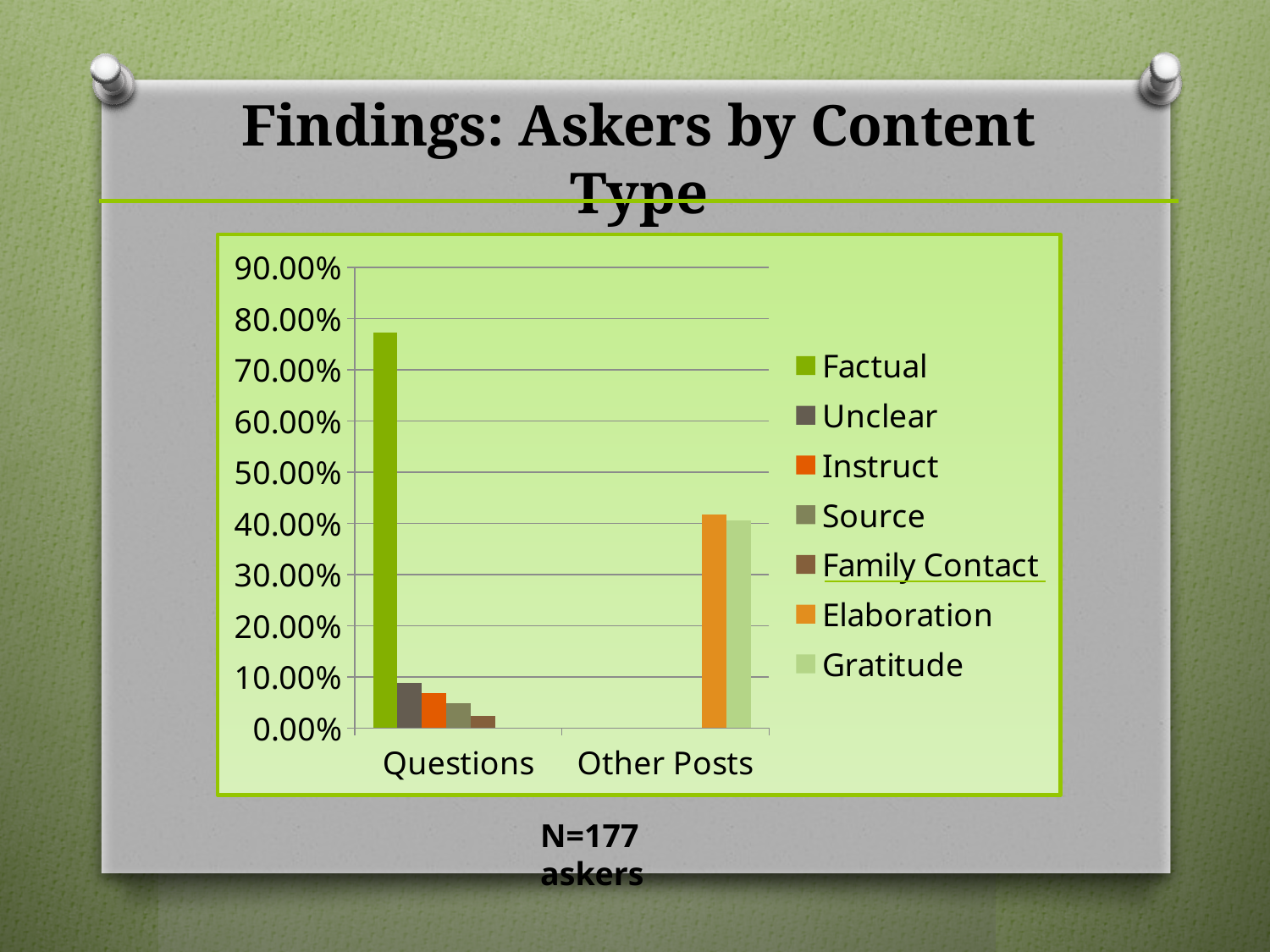
Is the value for Unclear in the Questions category greater or less than 20.00%? less What sample size is noted below the chart? N=177 askers Is the value for Factual in the Questions category greater or less than 70.00%? greater What is the title of the slide containing the chart? Findings: Askers by Content Type Which is larger: the Factual bar for Questions or the Elaboration bar for Other Posts? Factual bar for Questions How many series does the chart's legend list? 7 Is the value for Factual in the Questions category greater or less than 80.00%? less What kind of chart is shown on the slide? bar chart How many categories are shown on the x axis of the chart? 2 Which series has the highest bar in the Questions category? Factual Which series has the lowest visible bar in the Questions category? Family Contact